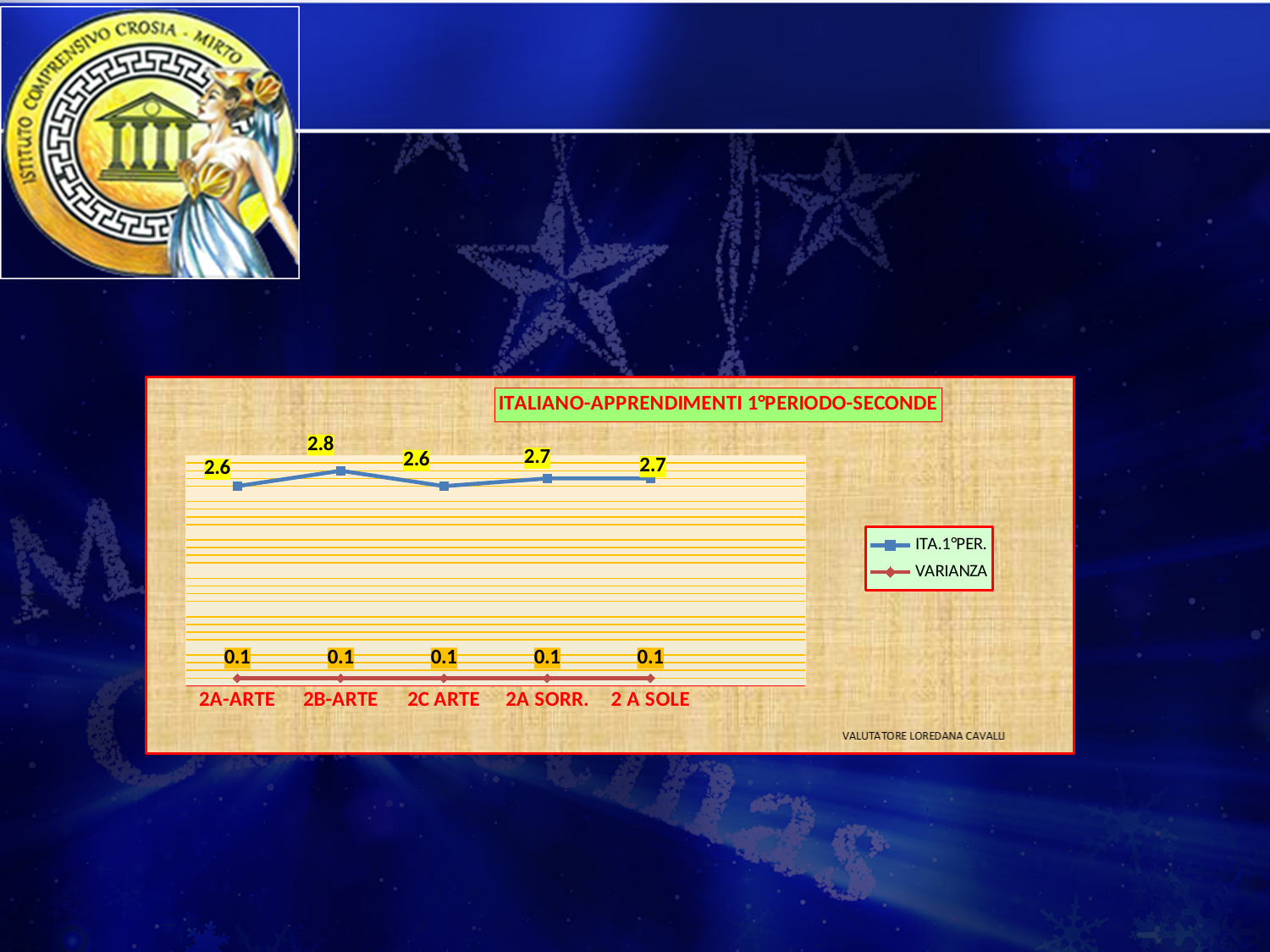
How many series does the legend list? 2 What is the VARIANZA value for 2C ARTE? 0.1 What is the title of the chart? ITALIANO-APPRENDIMENTI 1°PERIODO-SECONDE What is the ITA.1°PER. value for 2B-ARTE? 2.8 How many categories are shown on the x axis? 5 What kind of chart is shown on the slide? line chart Which is larger, the ITA.1°PER. value for 2B-ARTE or for 2A-ARTE? 2B-ARTE What is the difference between the ITA.1°PER. values for 2B-ARTE and 2C ARTE? 0.2 Which category has the highest ITA.1°PER. value? 2B-ARTE What is the difference between the ITA.1°PER. and VARIANZA values for 2 A SOLE? 2.6 What is the ITA.1°PER. value for 2A SORR.? 2.7 What are the two series listed in the legend? ITA.1°PER. and VARIANZA